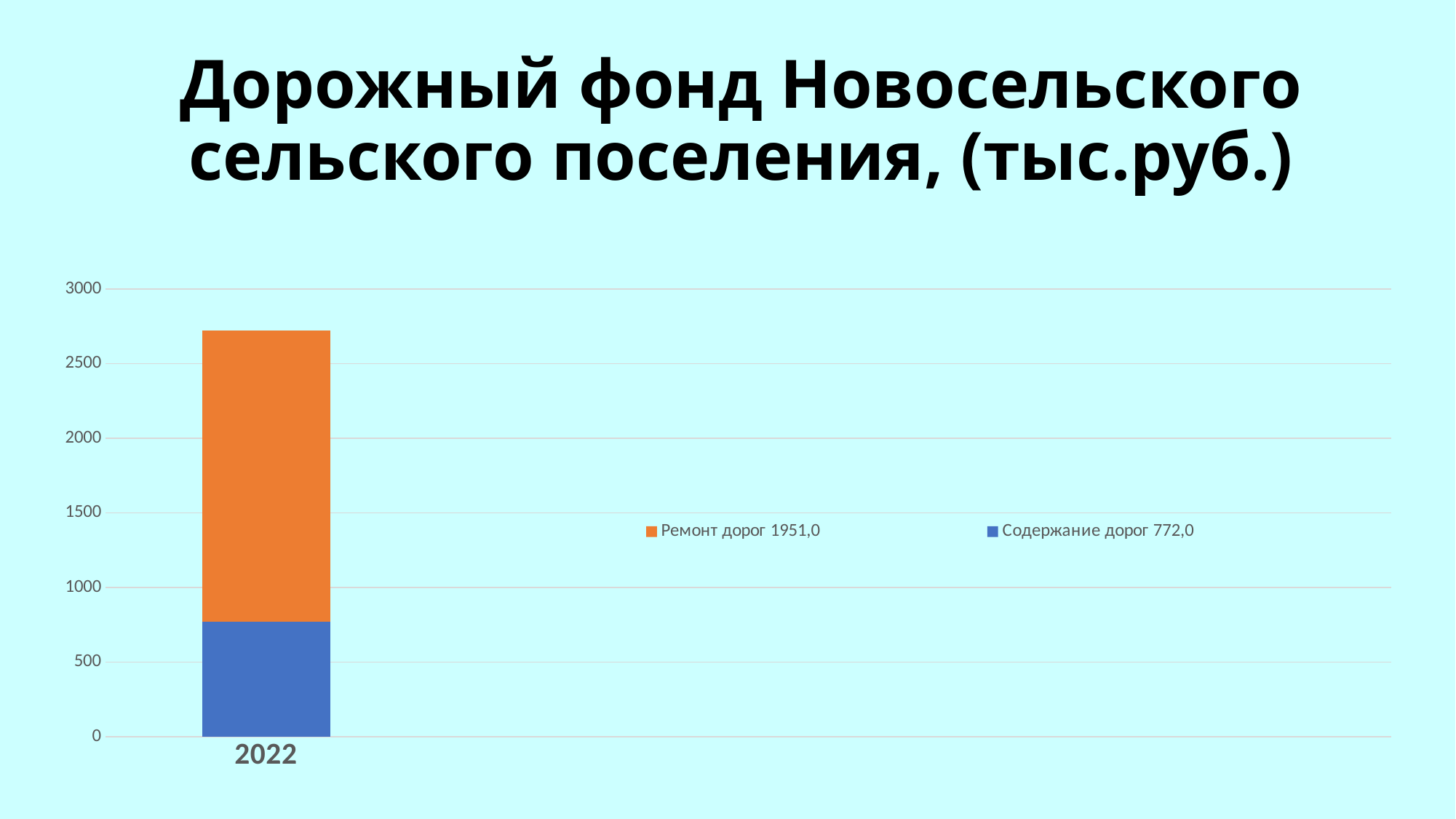
Which series has the larger value in 2022, Ремонт дорог or Содержание дорог? Ремонт дорог What is the value for Ремонт дорог in 2022? 1951,0 What is the title of the chart on the slide? Дорожный фонд Новосельского сельского поселения, (тыс.руб.) What is the value for Содержание дорог in 2022? 772,0 Is the total height of the 2022 bar greater or less than 2500? greater How many series does the legend list? 2 How many categories are shown on the x axis? 1 Which year is shown on the x axis? 2022 What kind of chart is shown on the slide? Stacked bar chart Is the value for Содержание дорог greater or less than 1000? less What is the total of the stacked bar for 2022? 2723,0 What is the difference between the values for Ремонт дорог and Содержание дорог in 2022? 1179,0